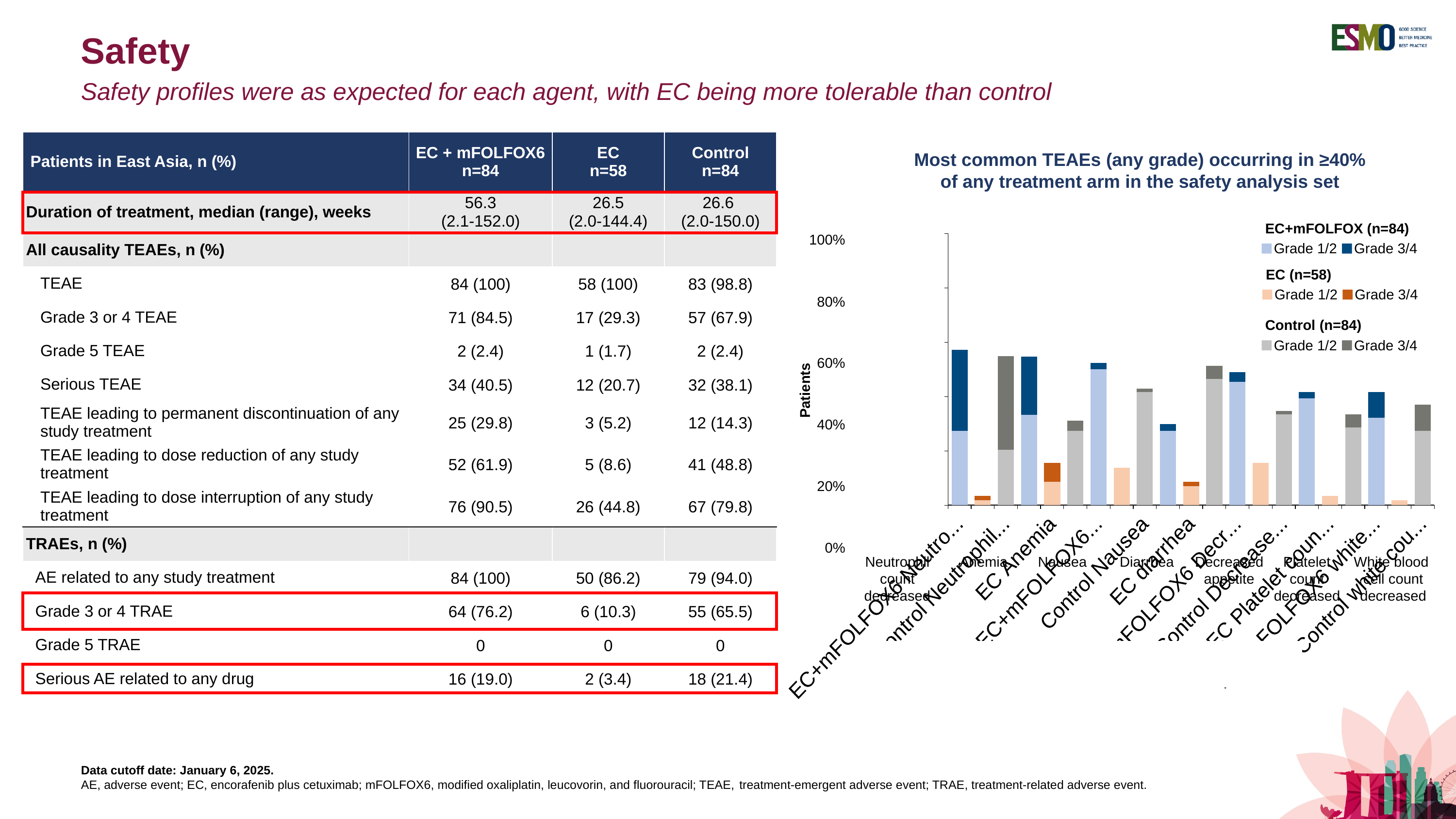
In the chart, is the total value for Diarrhea in the Control arm greater or less than 40%? greater What is the title of the chart? Most common TEAEs (any grade) occurring in ≥40% of any treatment arm in the safety analysis set In the chart, for Nausea, which arm has the taller total bar: EC+mFOLFOX or EC? EC+mFOLFOX What kind of chart is shown on the right side of the slide? Stacked bar chart In the chart, is the total value for Anemia in the EC arm greater or less than 40%? less In the chart, for Diarrhea, which arm has the taller total bar: EC+mFOLFOX or Control? Control In the chart, is the value for Neutrophil count decreased in the EC arm greater or less than 20%? less What is the label on the y axis of the chart? Patients How many adverse event categories are plotted on the x axis of the chart? 7 How many series does the chart legend list? 6